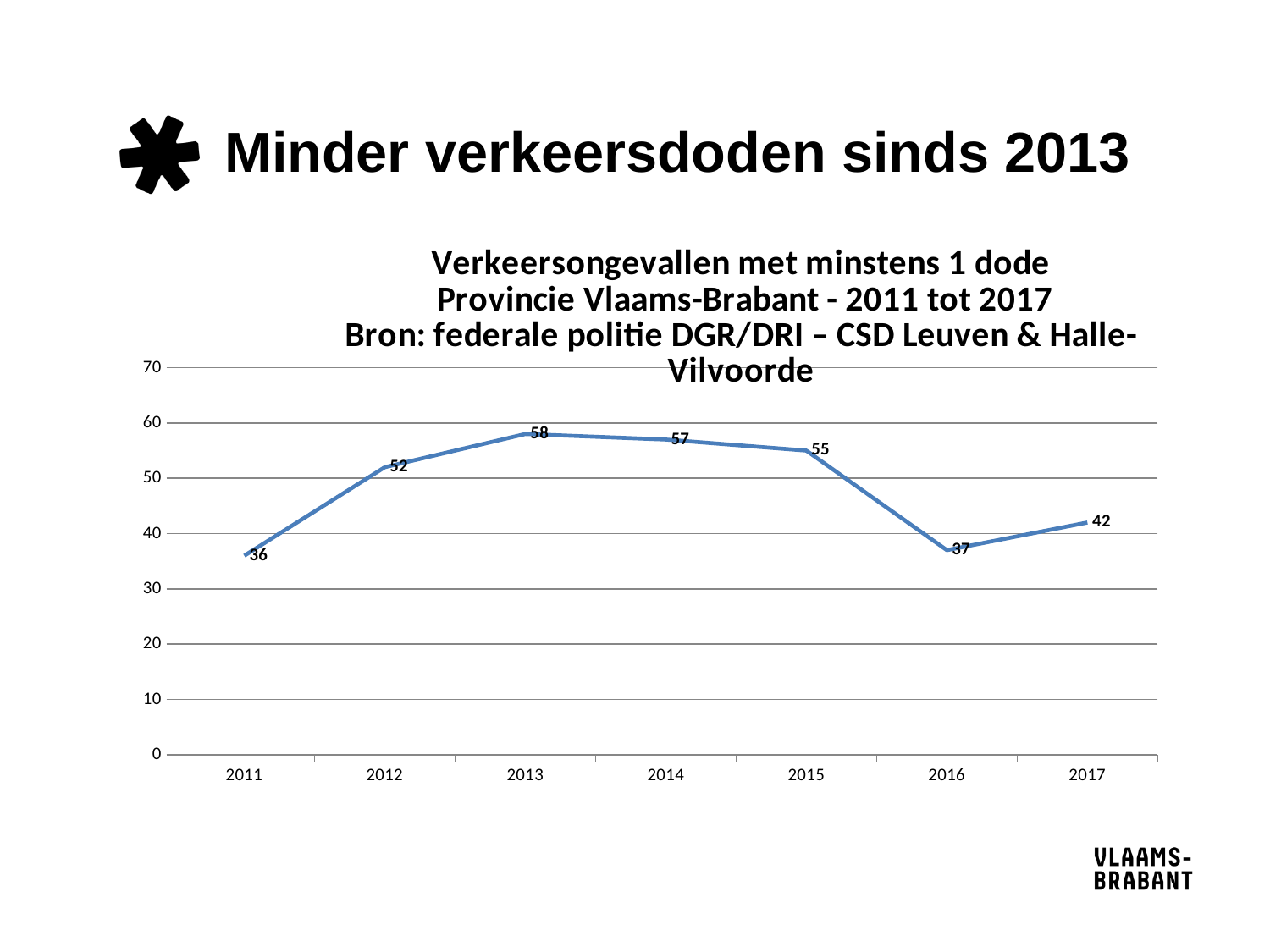
Which year has the lowest value? 2011 Do the values rise or fall from 2013 to 2016? fall What is the value for 2016? 37 What kind of chart is shown on the slide? line chart What is the difference between the values for 2013 and 2016? 21 What is the first line of the chart title? Verkeersongevallen met minstens 1 dode How many years are plotted on the chart? 7 Which year has the highest value? 2013 What is the value for 2013? 58 Is the value for 2015 greater or less than 50? greater Which is larger, the value for 2012 or the value for 2017? 2012 What is the value for 2011? 36